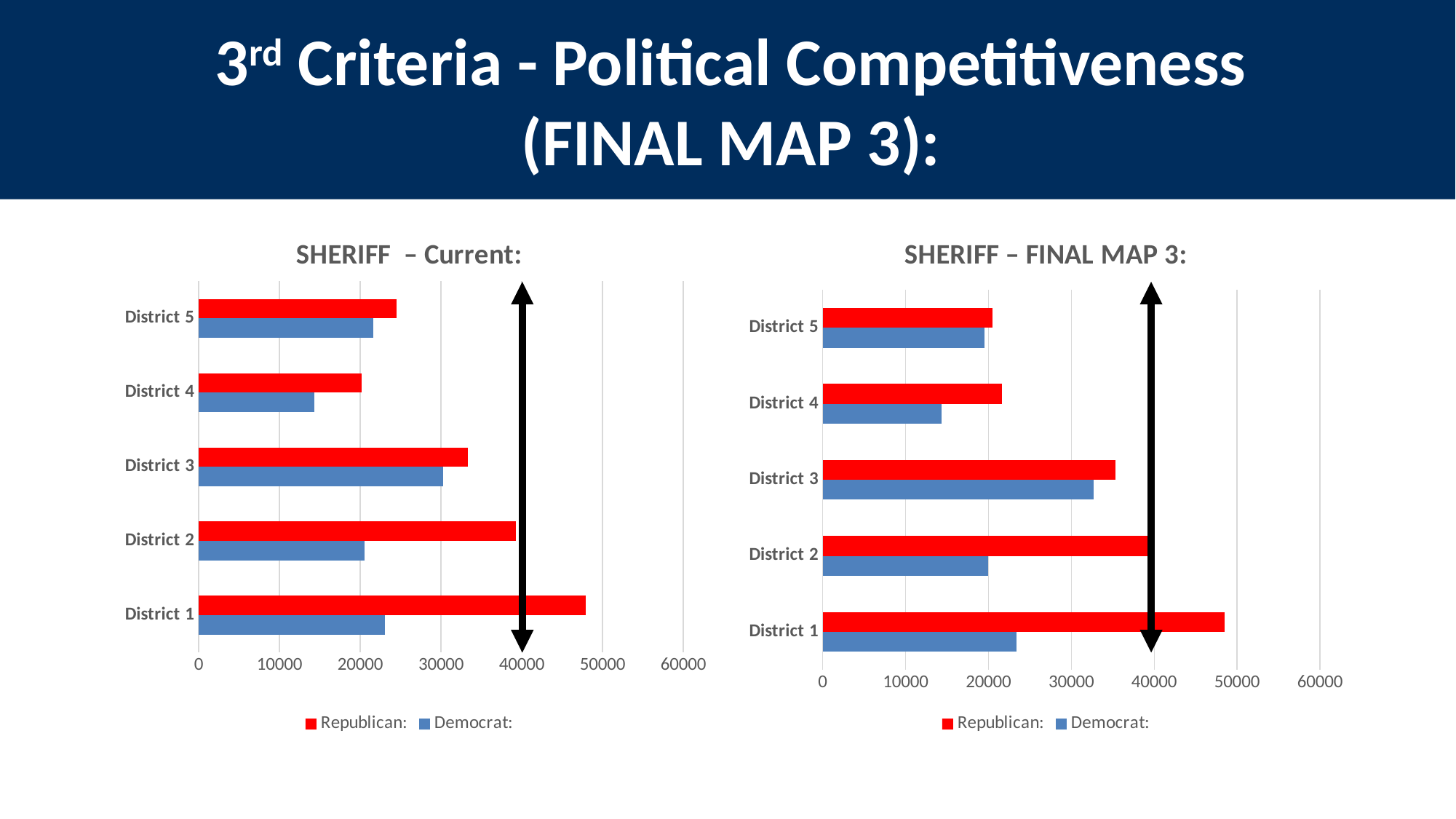
What kind of chart is the "SHERIFF – Current:" chart? bar chart How many series does the legend of the "SHERIFF – FINAL MAP 3:" chart list? 2 In the "SHERIFF – Current:" chart, is the Democrat value for District 4 greater or less than 20000? less In the "SHERIFF – FINAL MAP 3:" chart, which district has the highest Republican value? District 1 In the "SHERIFF – FINAL MAP 3:" chart, which is larger: the Republican value for District 2 or for District 3? District 2 How many districts are shown on the "SHERIFF – Current:" chart? 5 In the "SHERIFF – FINAL MAP 3:" chart, which district has the lowest Democrat value? District 4 In the "SHERIFF – Current:" chart, is the Republican value for District 1 greater or less than 40000? greater In the "SHERIFF – Current:" chart, which district has the lowest Democrat value? District 4 In the "SHERIFF – Current:" chart, which district has the highest Republican value? District 1 In the "SHERIFF – Current:" chart, what colour represents the Republican series? red In the "SHERIFF – FINAL MAP 3:" chart, is the Democrat value for District 3 greater or less than 30000? greater